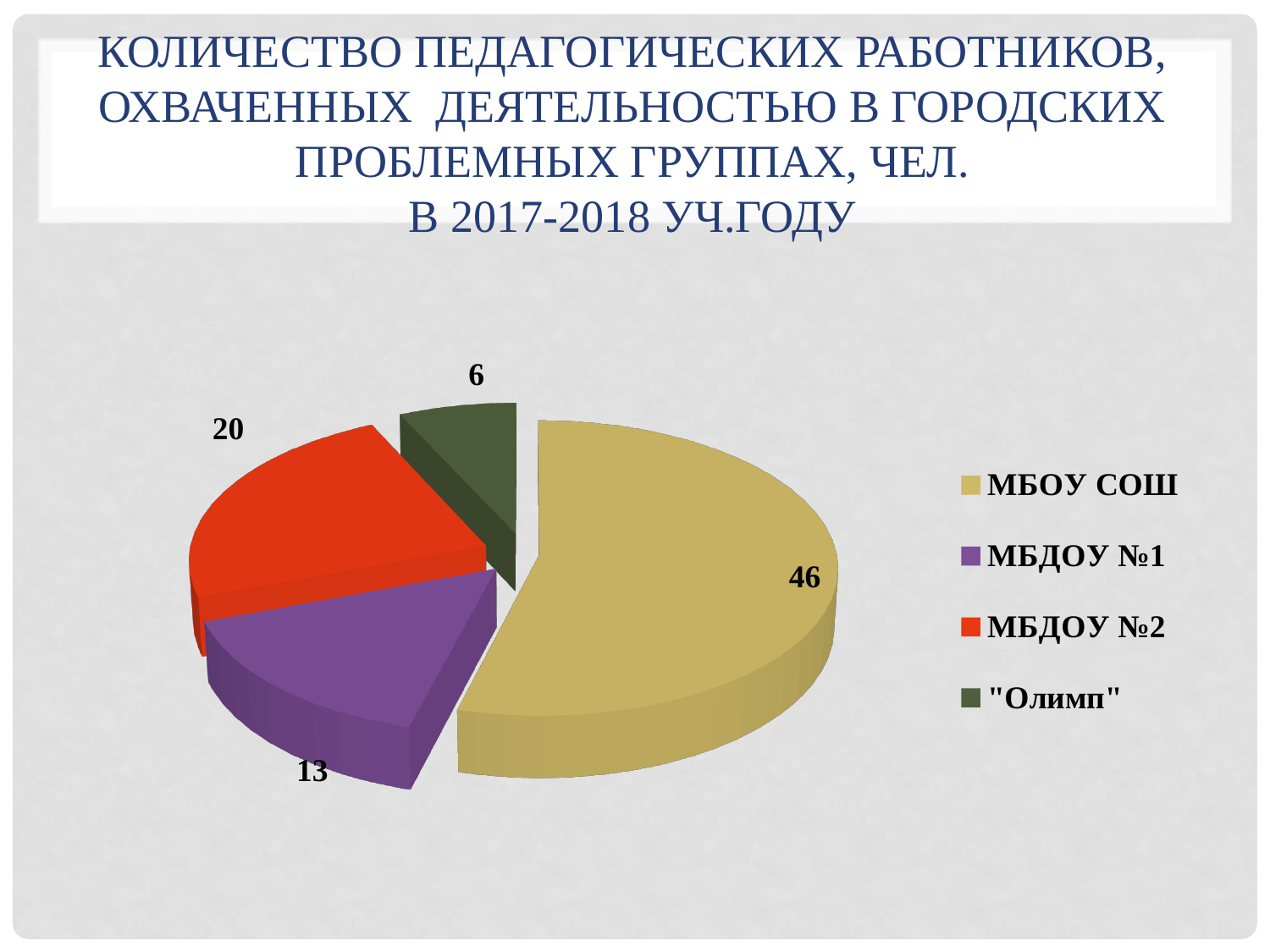
Which is larger, the value for МБДОУ №1 or the value for МБДОУ №2? МБДОУ №2 What is the value shown for МБДОУ №1? 13 What is the value shown for МБДОУ №2? 20 What colour is the slice for МБДОУ №2? Red Which category has the largest slice of the pie? МБОУ СОШ What is the total of all the slices in the pie chart? 85 How many categories does the pie chart have? 4 What type of chart is shown on the slide? Pie chart Which category has the smallest slice of the pie? "Олимп" How many teaching staff does the МБОУ СОШ slice represent? 46 What is the value shown for "Олимп"? 6 What is the difference between the values for МБОУ СОШ and МБДОУ №2? 26